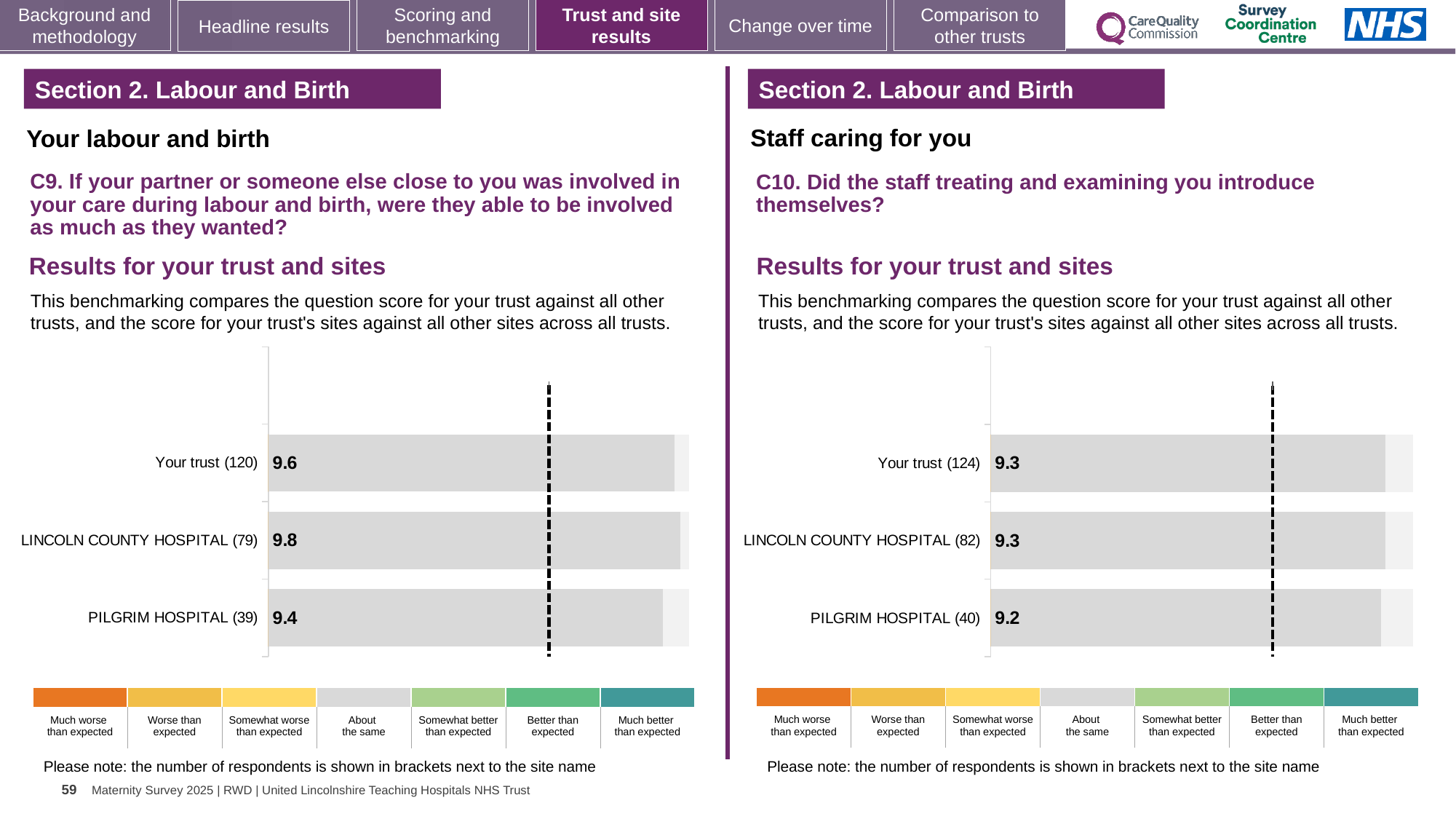
In the C9 chart on the left, which site or trust has the lowest score? PILGRIM HOSPITAL (39) How many bars are shown in the C10 chart on the right? 3 In the C9 chart on the left, what is the score for PILGRIM HOSPITAL (39)? 9.4 What type of chart is used in the C9 chart on the left? Bar chart In the C9 chart on the left, which has the larger score, Your trust (120) or PILGRIM HOSPITAL (39)? Your trust (120) In the C9 chart on the left, which site or trust has the highest score? LINCOLN COUNTY HOSPITAL (79) In the C9 chart on the left, what is the score for Your trust (120)? 9.6 In the C10 chart on the right, which site or trust has the lowest score? PILGRIM HOSPITAL (40) In the C10 chart on the right, what is the score for PILGRIM HOSPITAL (40)? 9.2 In the C9 chart on the left, what is the score for LINCOLN COUNTY HOSPITAL (79)? 9.8 In the C9 chart on the left, what is the difference between the scores for LINCOLN COUNTY HOSPITAL (79) and PILGRIM HOSPITAL (39)? 0.4 In the C10 chart on the right, what is the score for Your trust (124)? 9.3